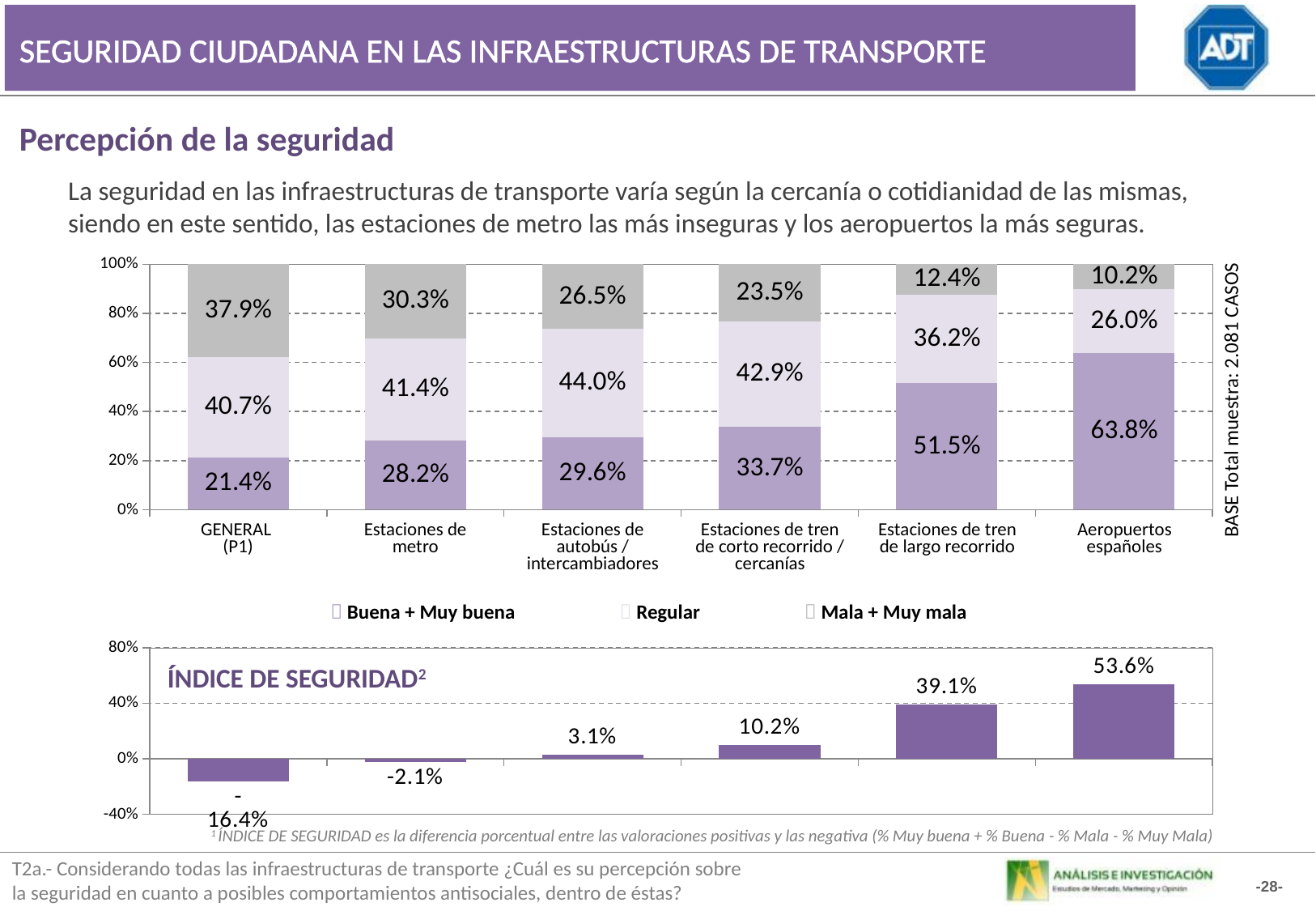
In the ÍNDICE DE SEGURIDAD chart at the bottom, is the value for Estaciones de metro larger or smaller than the value for Estaciones de autobús / intercambiadores? smaller In the top stacked bar chart, how many series does the legend list? 3 In the top stacked bar chart, which category has the highest 'Buena + Muy buena' value? Aeropuertos españoles In the top stacked bar chart, what is the 'Buena + Muy buena' value for Aeropuertos españoles? 63.8% In the ÍNDICE DE SEGURIDAD chart at the bottom, what is the value for Estaciones de tren de largo recorrido? 39.1% What kind of chart is the ÍNDICE DE SEGURIDAD chart at the bottom of the slide? bar chart In the top stacked bar chart, what is the 'Mala + Muy mala' value for GENERAL (P1)? 37.9% In the top stacked bar chart, how many categories are shown on the x axis? 6 In the top stacked bar chart, what is the difference between the 'Buena + Muy buena' values for Estaciones de tren de largo recorrido and Estaciones de metro? 23.3% In the ÍNDICE DE SEGURIDAD chart at the bottom, which category has the lowest value? GENERAL (P1) In the top stacked bar chart, what is the 'Regular' value for Estaciones de autobús / intercambiadores? 44.0% In the top stacked bar chart, which category has the lowest 'Mala + Muy mala' value? Aeropuertos españoles